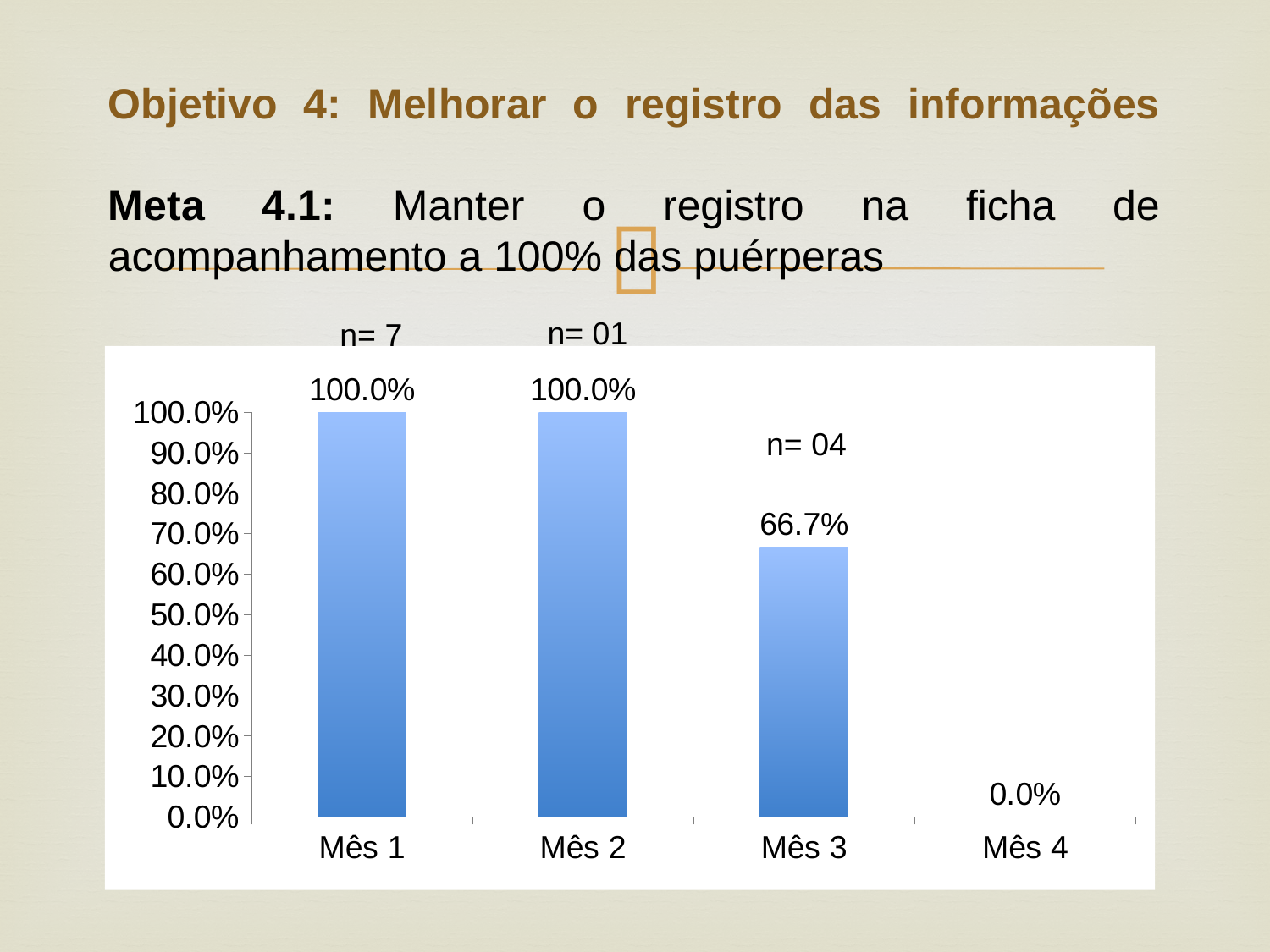
What is the value for Mês 1? 100.0% What kind of chart is shown on the slide? bar chart What is the n value annotated above the bar for Mês 3? n= 04 Which is larger, the value for Mês 1 or the value for Mês 3? Mês 1 What is the value for Mês 4? 0.0% What is the value for Mês 3? 66.7% Which category has the lowest value? Mês 4 What is the difference between the values for Mês 2 and Mês 3? 33.3% What is the highest tick value shown on the y axis? 100.0% Do the values rise or fall from Mês 2 to Mês 4? fall How many categories are shown on the x axis? 4 Is the value for Mês 3 greater or less than 60.0%? greater